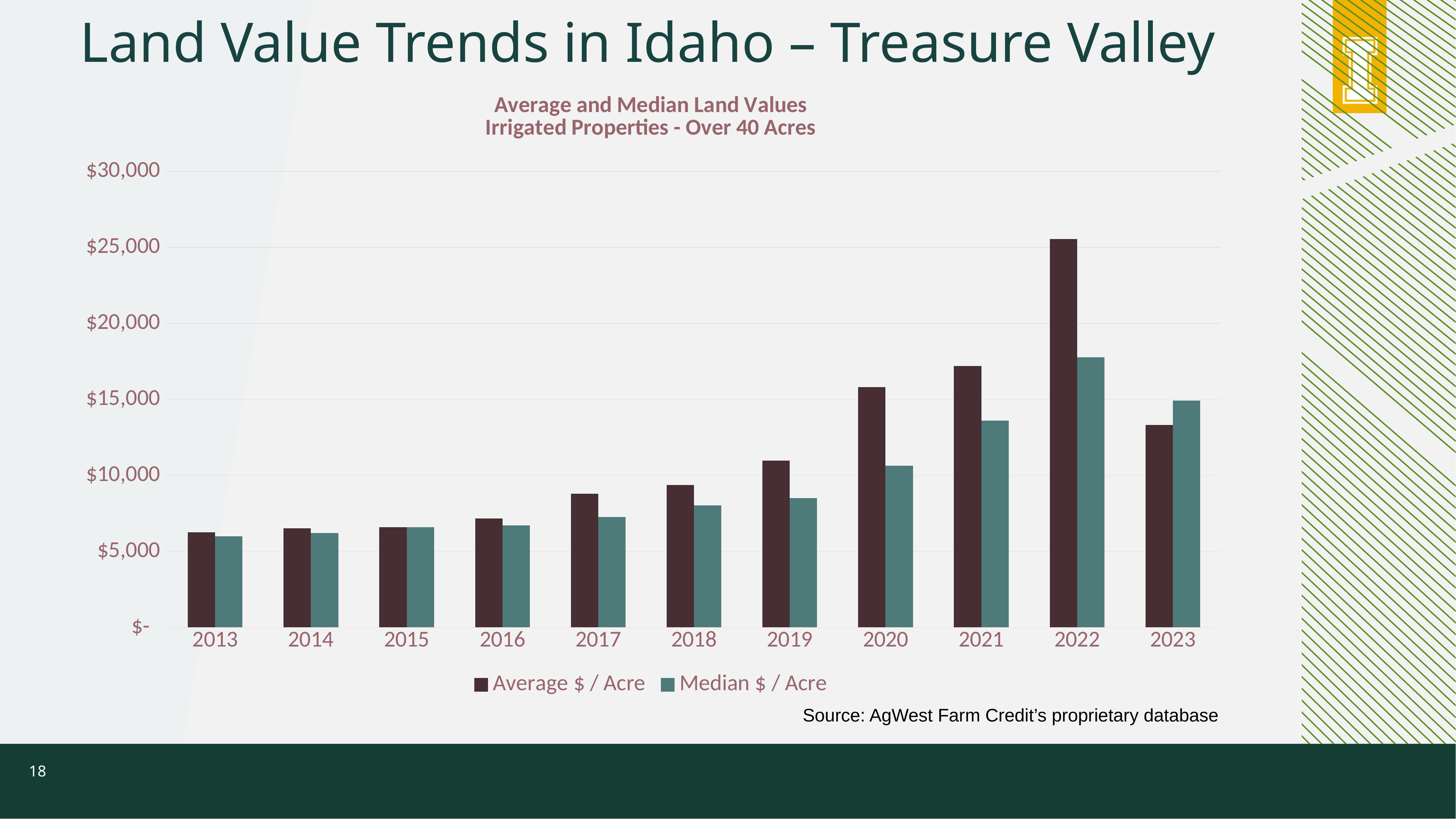
Which year has the highest Average $ / Acre? 2022 Is the Average $ / Acre for 2023 greater or less than $15,000? less Is the Average $ / Acre for 2022 greater or less than $25,000? greater In 2023, which is larger: Average $ / Acre or Median $ / Acre? Median $ / Acre Which is larger: the Average $ / Acre in 2021 or in 2022? 2022 Does the Average $ / Acre generally rise or fall from 2013 to 2022? Rise Is the Median $ / Acre for 2020 greater or less than $10,000? greater How many years are shown on the x axis? 11 Which year has the highest Median $ / Acre? 2022 How many series does the legend list? 2 What is the title of the chart? Average and Median Land Values Irrigated Properties - Over 40 Acres What kind of chart is shown on the slide? Bar chart